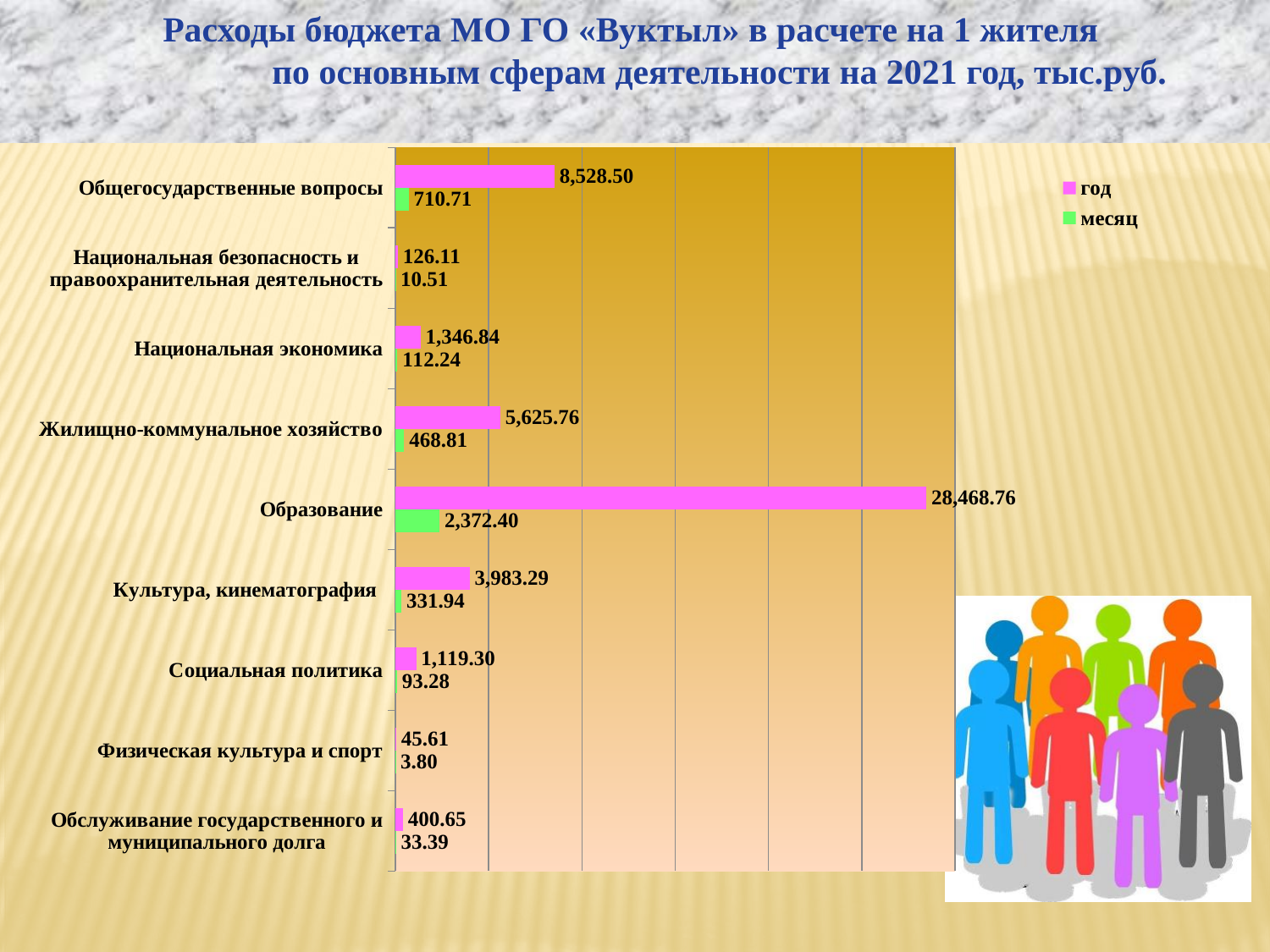
What are the two entries in the chart legend? год and месяц What type of chart is shown on the slide? Bar chart What is the "месяц" value for Социальная политика? 93.28 What is the value of the "месяц" series for Жилищно-коммунальное хозяйство? 468.81 What is the "год" value for Культура, кинематография? 3,983.29 Which category has the highest "год" value? Образование How many categories are shown on the chart? 9 Which category has the lowest "год" value? Физическая культура и спорт What is the value of the "год" series for Образование? 28,468.76 How many series does the legend list? 2 What is the difference between the "год" and "месяц" values for Общегосударственные вопросы? 7,817.79 Which has the larger "год" value: Национальная экономика or Социальная политика? Национальная экономика